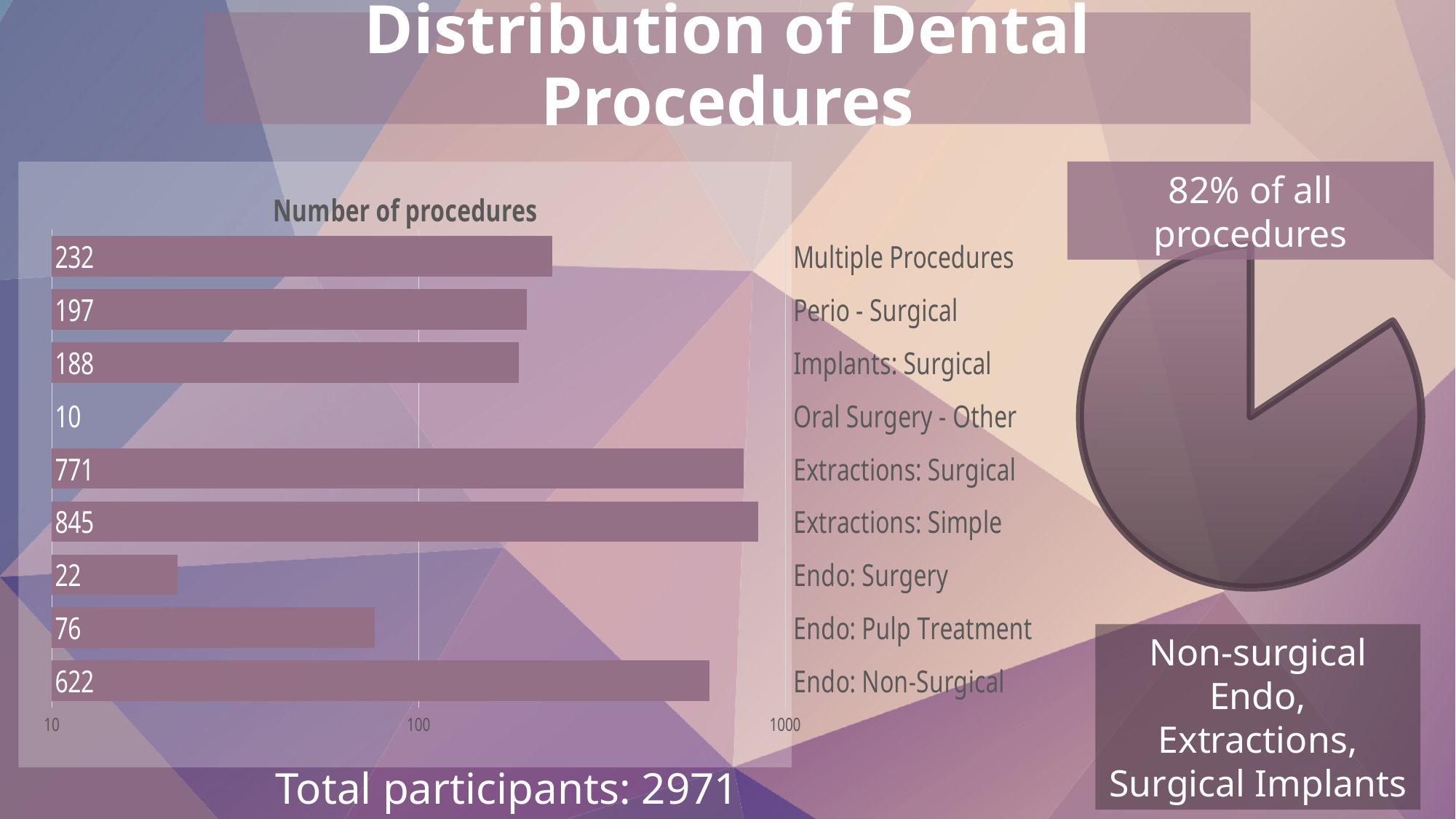
In the 'Number of procedures' bar chart, what is the value for Perio - Surgical? 197 In the 'Number of procedures' bar chart, what is the value for Extractions: Simple? 845 In the 'Number of procedures' bar chart, which category has the lowest value? Oral Surgery - Other In the pie chart on the right of the slide, what share of all procedures does the highlighted slice represent? 82% In the 'Number of procedures' bar chart, which category has the highest value? Extractions: Simple In the 'Number of procedures' bar chart, what is the difference between Extractions: Simple and Extractions: Surgical? 74 In the 'Number of procedures' bar chart, is the value for Endo: Pulp Treatment greater or less than 100? less What kind of chart is the 'Number of procedures' chart on the left of the slide? bar chart What is the title of the bar chart on the left of the slide? Number of procedures In the 'Number of procedures' bar chart, what is the value for Endo: Non-Surgical? 622 In the 'Number of procedures' bar chart, which is larger: Multiple Procedures or Implants: Surgical? Multiple Procedures How many categories are shown in the 'Number of procedures' bar chart? 9